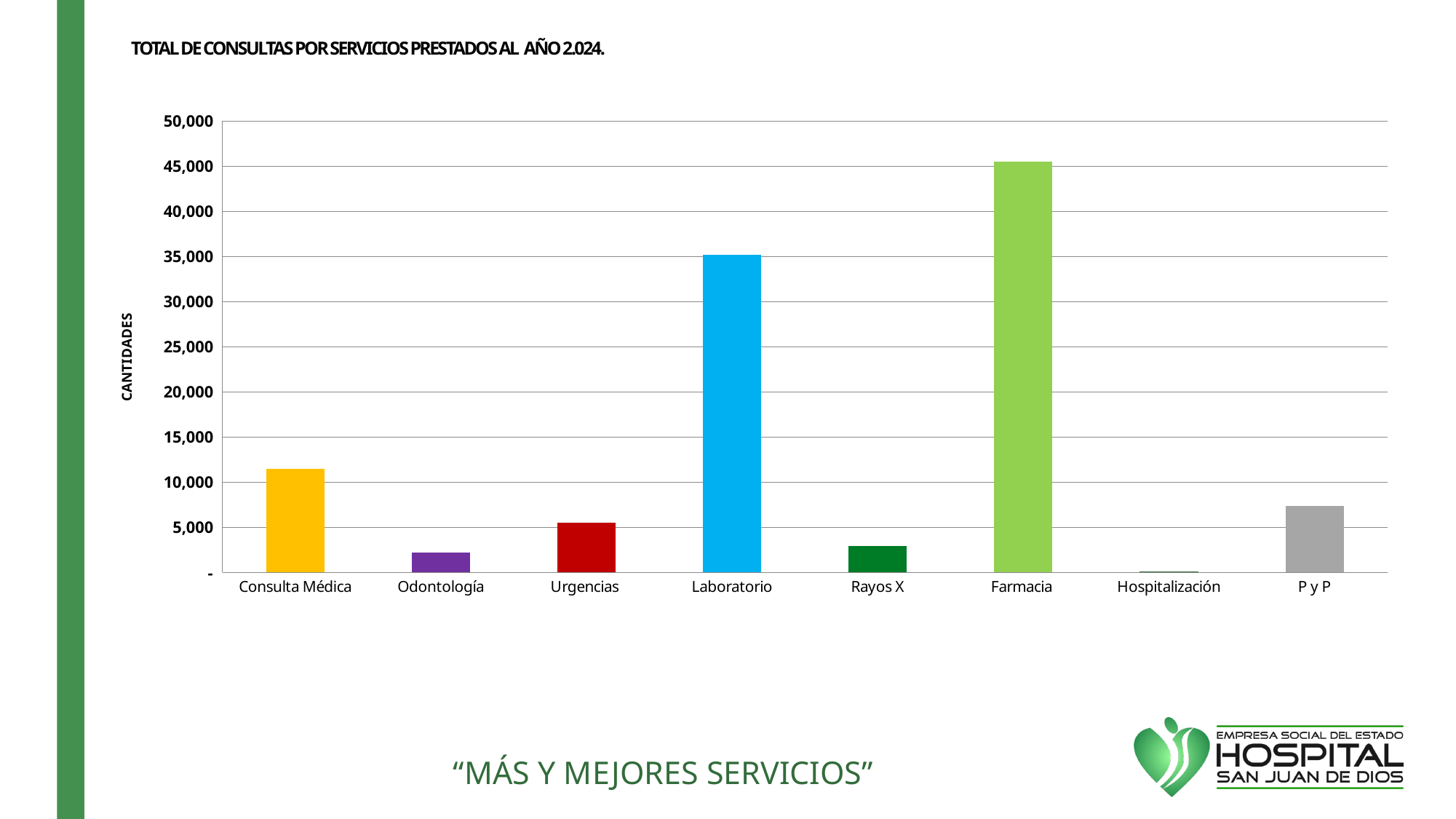
Which service has the lowest number of consultations? Hospitalización What kind of chart is shown on the slide? bar chart Which is larger, the value for Laboratorio or the value for Consulta Médica? Laboratorio Is the value for Consulta Médica greater or less than 10,000? greater How many service categories are shown on the x axis? 8 Is the value for Farmacia greater or less than 45,000? greater Which is larger, the value for Urgencias or the value for Odontología? Urgencias What is the title of the chart? TOTAL DE CONSULTAS POR SERVICIOS PRESTADOS AL AÑO 2.024. Is the value for Urgencias greater or less than 10,000? less Which service has the highest number of consultations? Farmacia